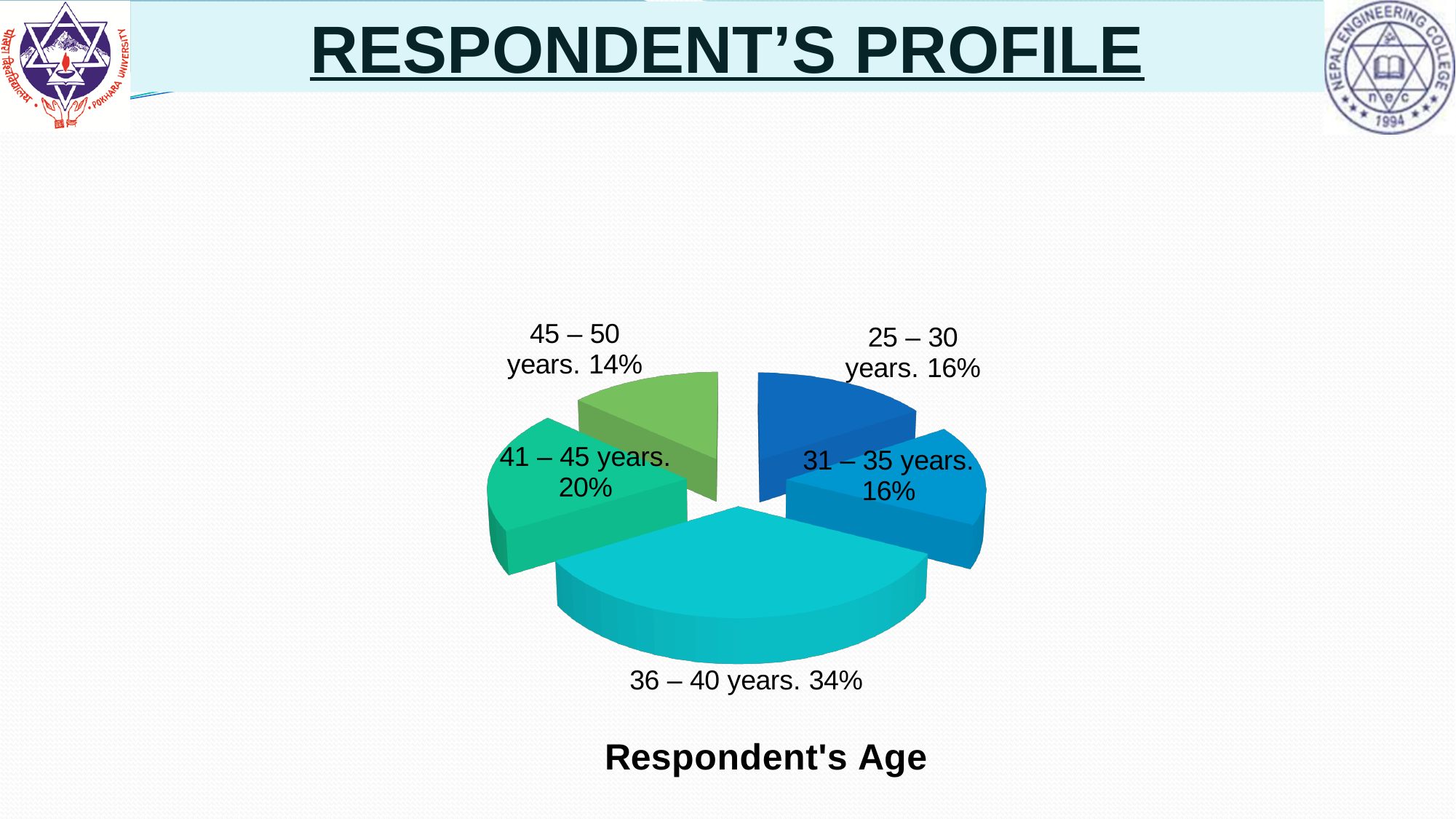
Which group has a larger share: 41 – 45 years or 45 – 50 years? 41 – 45 years What is the combined share of the 25 – 30 years and 31 – 35 years groups? 32% What is the title of the chart? Respondent's Age Which age group has the smallest share of respondents? 45 – 50 years How many age groups are shown in the pie chart? 5 What percentage of respondents fall in the 41 – 45 years age group? 20% What percentage of respondents are in the 25 – 30 years group? 16% What type of chart is used to show the respondents' age? Pie chart What is the difference in percentage points between the 36 – 40 years group and the 41 – 45 years group? 14 What share of respondents are aged 45 – 50 years? 14% What share of respondents are aged 36 – 40 years? 34% Which age group has the largest share of respondents? 36 – 40 years